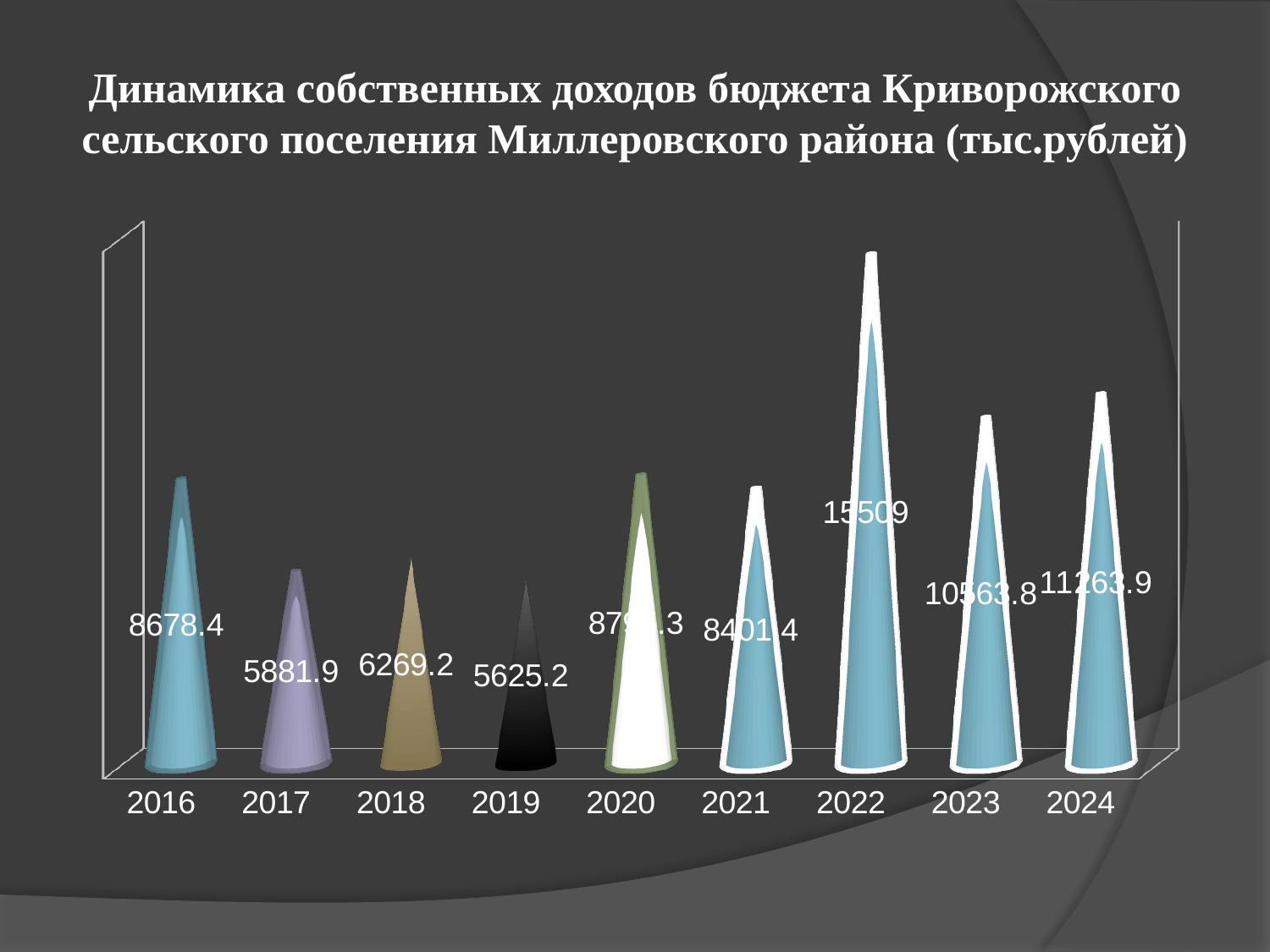
Which is larger, the value for 2016 or the value for 2021? 2016 What is the value for 2016? 8678.4 What is the difference between the values for 2016 and 2017? 2796.5 How many years are shown on the x axis? 9 What is the value for 2024? 11263.9 What is the value for 2022? 15509 What is the value for 2019? 5625.2 What is the difference between the values for 2022 and 2024? 4245.1 What is the value for 2017? 5881.9 Which year has the highest value? 2022 Which year has the lowest value? 2019 What kind of chart is this? bar chart